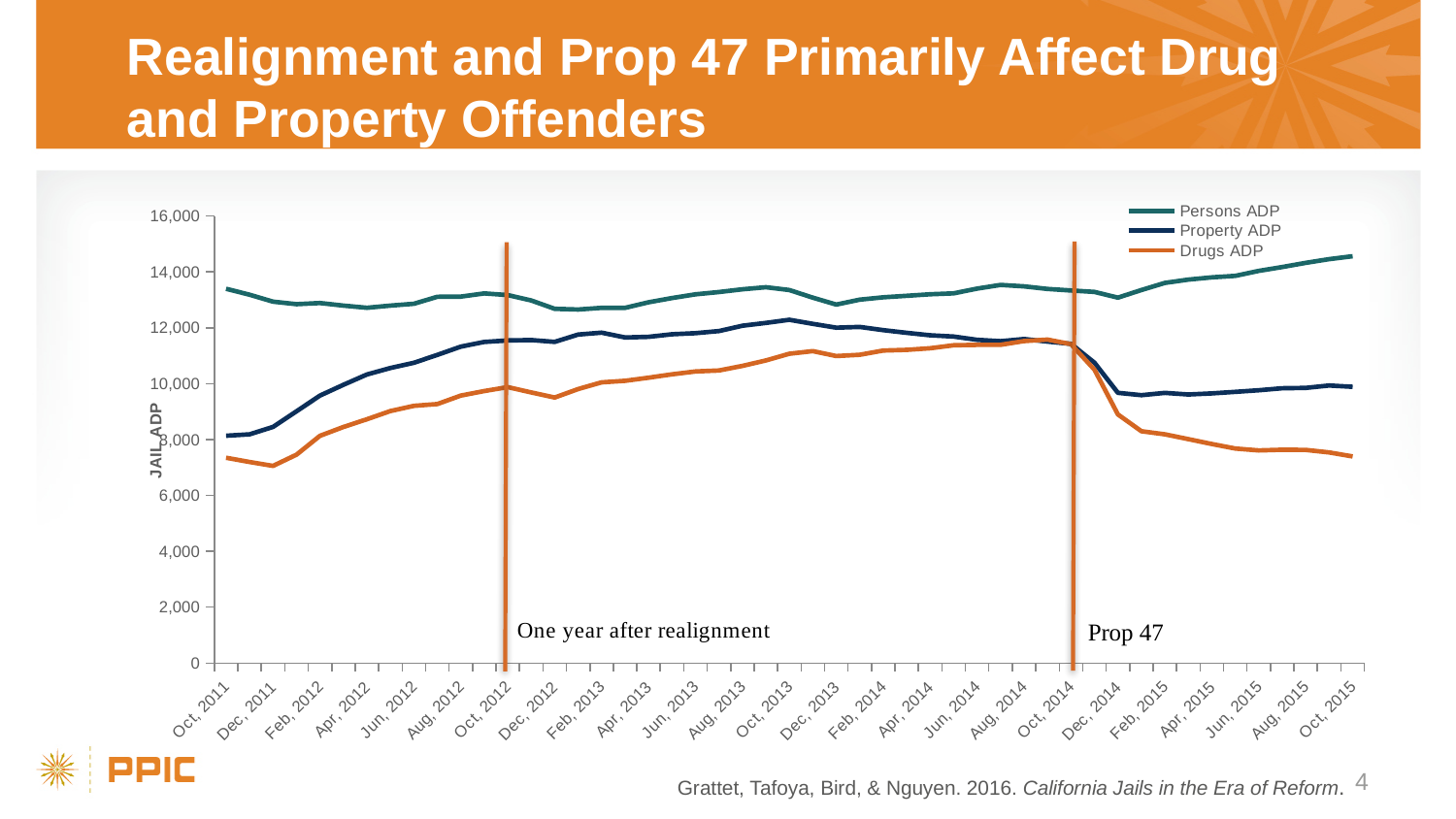
What label is shown on the y axis? JAIL ADP Is the value for Drugs ADP in Dec, 2011 greater or less than 8,000? less How many series does the legend list? 3 In Oct, 2015, which is larger: Property ADP or Drugs ADP? Property ADP Which series has the lowest value in Oct, 2015? Drugs ADP Which series has the highest values across the whole period? Persons ADP Is the value for Drugs ADP in Oct, 2015 greater or less than 8,000? less Is the value for Property ADP in Oct, 2013 greater or less than 12,000? greater What event does the second vertical line on the chart mark? Prop 47 What kind of chart is shown on the slide? Line chart Does Drugs ADP rise or fall between Oct, 2014 and Oct, 2015? Fall